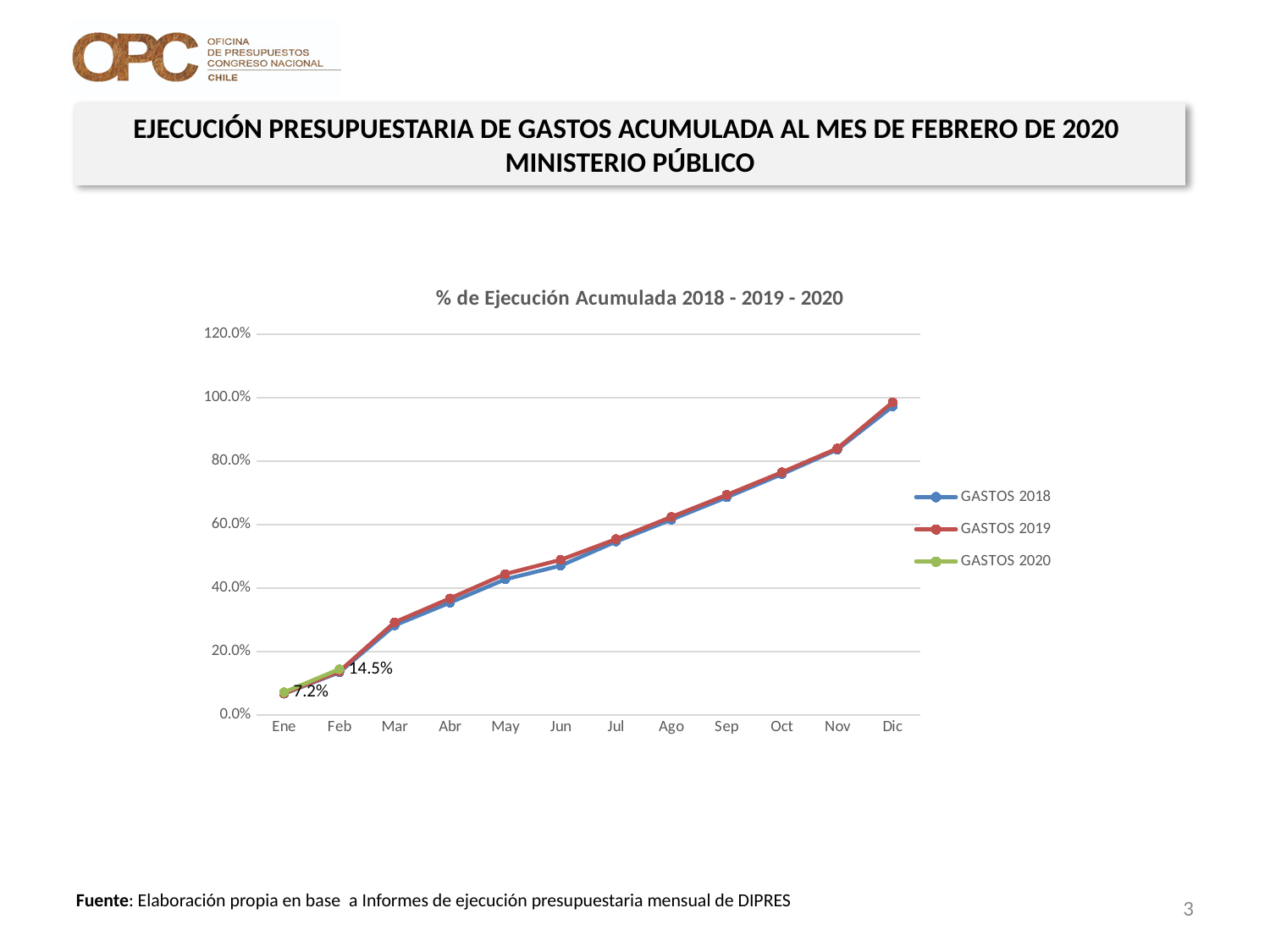
What kind of chart is shown on the slide? line chart How many months are shown on the x axis? 12 Is the value for GASTOS 2019 in Dic greater or less than 80.0%? greater Which is larger for GASTOS 2020, the value in Ene or in Feb? Feb What is the value for GASTOS 2020 in Feb? 14.5% What is the difference between the GASTOS 2020 values for Feb and Ene? 7.3% Do the GASTOS 2019 values rise or fall from Ene to Dic? rise How many series does the legend list? 3 Is the value for GASTOS 2018 in Mar greater or less than 40.0%? less What is the title of the chart? % de Ejecución Acumulada 2018 - 2019 - 2020 In which month does GASTOS 2019 reach its highest value? Dic What is the value for GASTOS 2020 in Ene? 7.2%